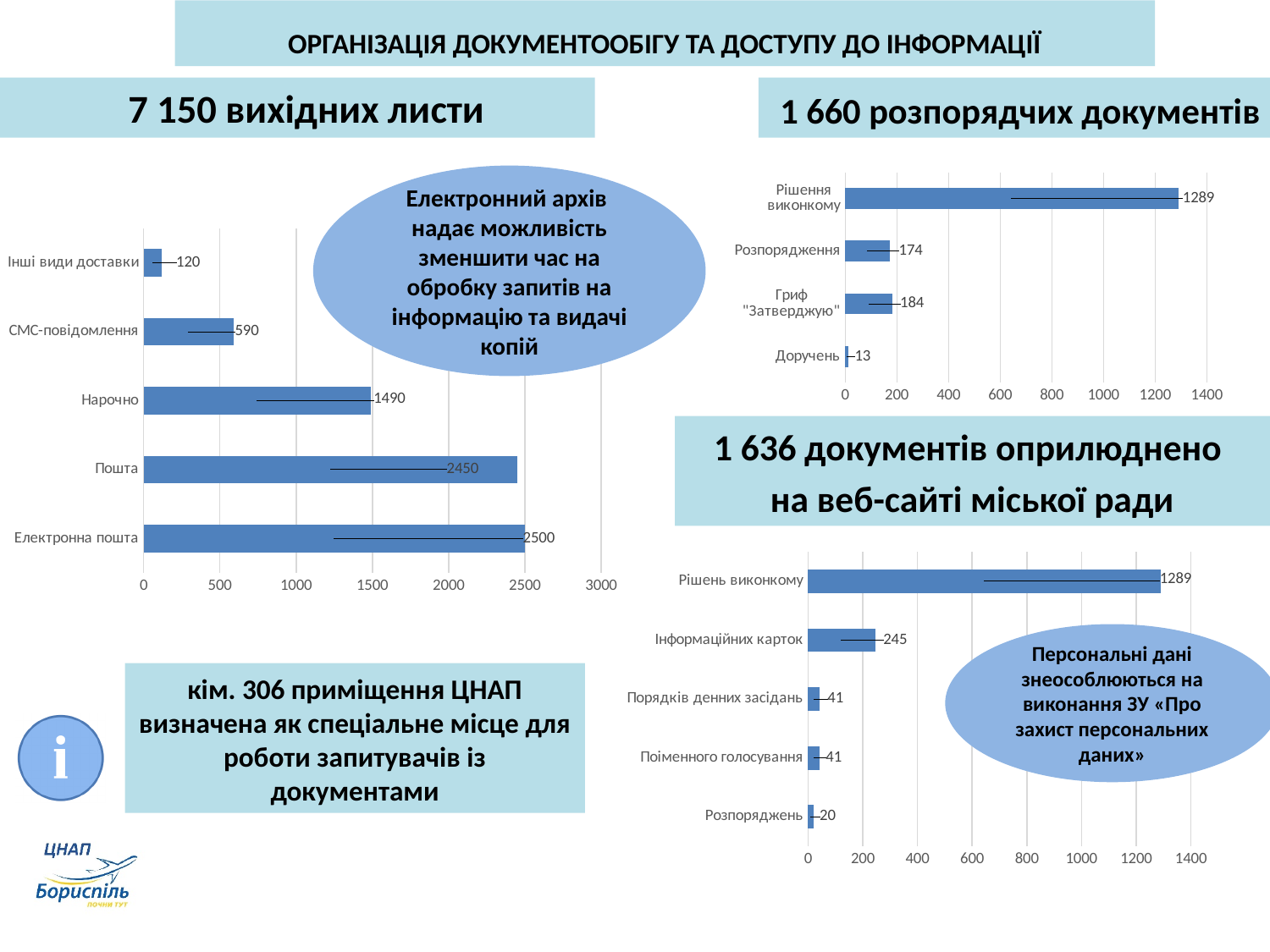
In the top-right chart (1 660 розпорядчих документів), which category has the lowest value? Доручень In the top-right chart (1 660 розпорядчих документів), what is the value for Розпорядження? 174 How many categories are shown in the bottom-right chart (1 636 документів оприлюднено на веб-сайті міської ради)? 5 In the top-right chart (1 660 розпорядчих документів), which is larger: Гриф "Затверджую" or Розпорядження? Гриф "Затверджую" How many categories are shown in the left chart (7 150 вихідних листи)? 5 In the left chart (7 150 вихідних листи), which category has the lowest value? Інші види доставки What type of chart is the top-right chart (1 660 розпорядчих документів)? Bar chart In the bottom-right chart (1 636 документів оприлюднено на веб-сайті міської ради), what is the difference between Рішень виконкому and Інформаційних карток? 1044 In the left chart (7 150 вихідних листи), what is the difference between Нарочно and СМС-повідомлення? 900 In the left chart (7 150 вихідних листи), what is the value for Пошта? 2450 In the bottom-right chart (1 636 документів оприлюднено на веб-сайті міської ради), what is the value for Інформаційних карток? 245 In the left chart (7 150 вихідних листи), which category has the highest value? Електронна пошта